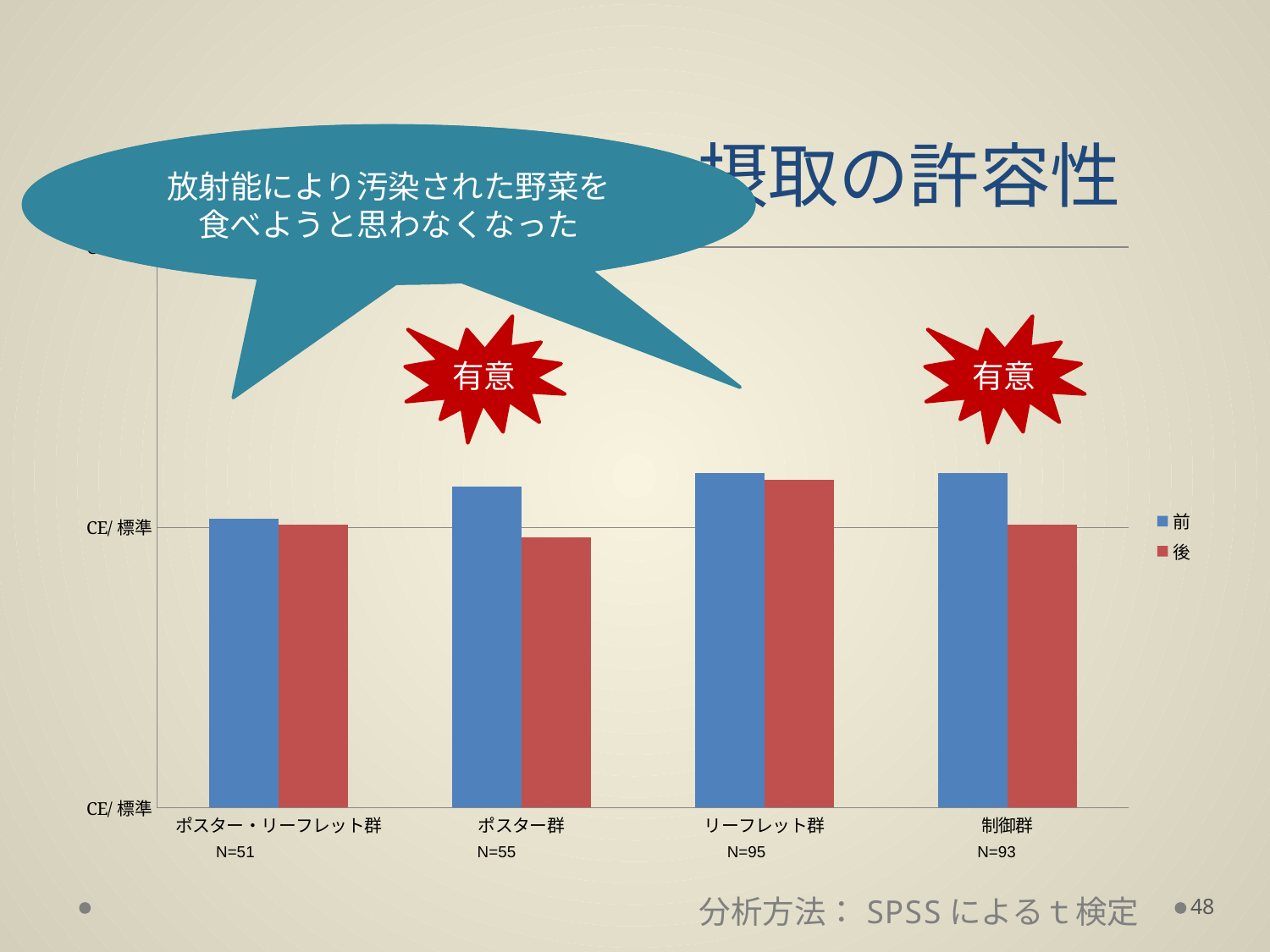
For ポスター群, which is larger, the 前 bar or the 後 bar? 前 What kind of chart is shown on the slide? bar chart Which group has the lowest 後 bar? ポスター群 For 制御群, which is larger, the 前 bar or the 後 bar? 前 Which is larger, the 後 bar for リーフレット群 or the 後 bar for ポスター群? リーフレット群 Which group has the lowest 前 bar? ポスター・リーフレット群 Which group has the highest 後 bar? リーフレット群 How many groups (categories) are shown on the x axis of the chart? 4 What are the two series names listed in the chart's legend? 前, 後 How many series does the chart's legend list? 2 What sample size (N) is shown under リーフレット群? N=95